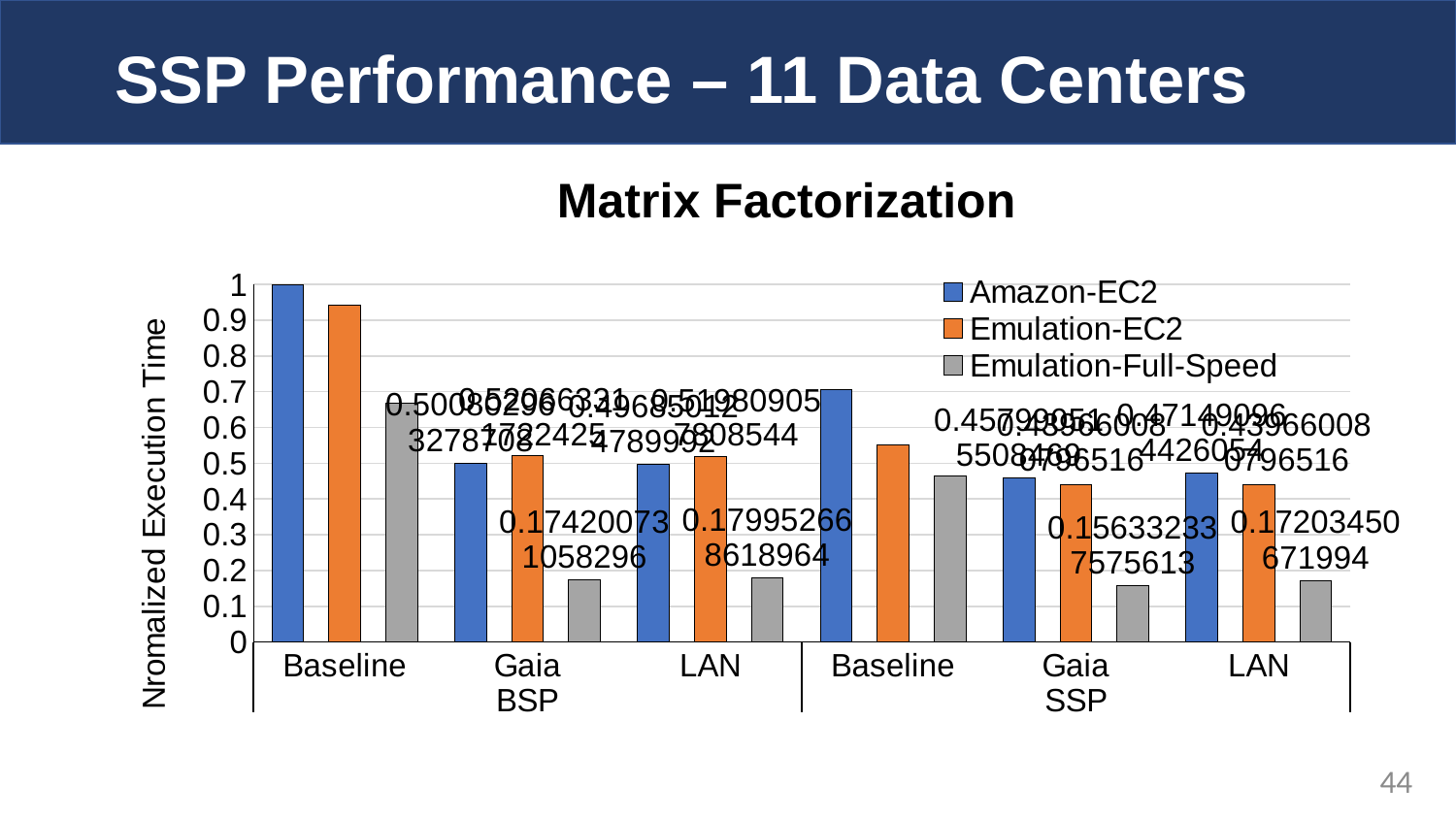
What are the three series named in the legend? Amazon-EC2, Emulation-EC2, Emulation-Full-Speed Which is larger: Amazon-EC2 at Baseline under BSP or Amazon-EC2 at Baseline under SSP? Amazon-EC2 at Baseline under BSP Within the Gaia SSP group, which series has the lowest value? Emulation-Full-Speed What is the title of the chart? Matrix Factorization Is the value for Amazon-EC2 at Baseline under SSP greater or less than 0.6? greater How many series does the legend list? 3 Is the value for Emulation-Full-Speed at Baseline under BSP greater or less than 0.5? greater What is the normalized execution time for Amazon-EC2 at Baseline under BSP? 1 How many category groups are shown along the x axis? 6 What type of chart is shown on the slide? bar chart Is the value for Emulation-EC2 at Baseline under BSP greater or less than 0.9? greater Which bar is the highest in the chart? Amazon-EC2 at Baseline (BSP)